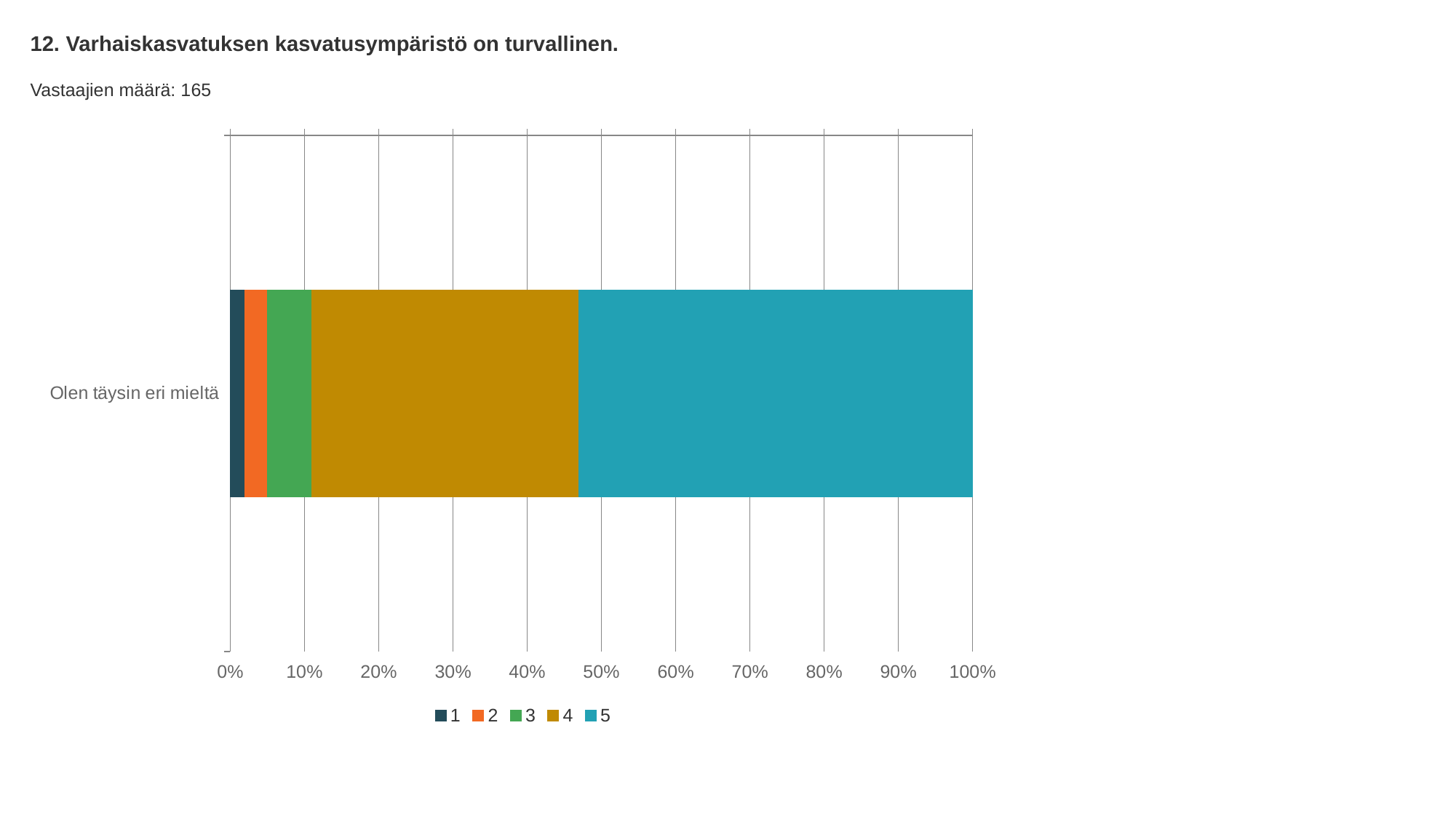
Is the share for series 4 greater or less than 30%? greater How many respondents (Vastaajien määrä) are reported on the slide? 165 What is the total of the stacked bar? 100% Is the share for series 3 greater or less than 10%? less What kind of chart is shown on the slide? Stacked bar chart How many categories are plotted on the y axis? 1 Which series has the larger share of the bar, 2 or 3? 3 Is the share for series 5 greater or less than 50%? greater Which series takes up the largest share of the bar? 5 How many series does the legend list? 5 Which series takes up the smallest share of the bar? 1 Which series has the larger share of the bar, 4 or 5? 5